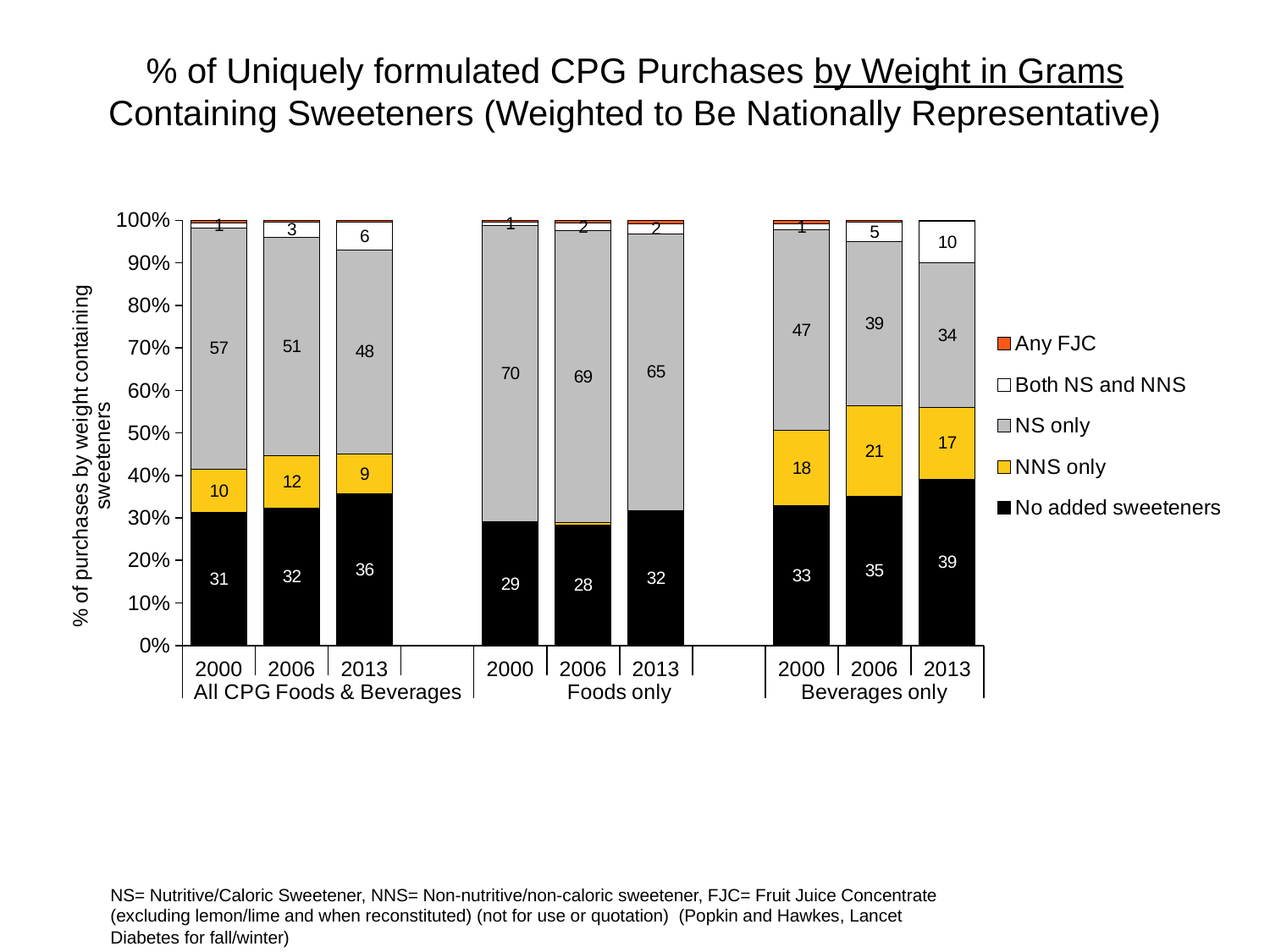
What is the value of the NS only segment for Foods only in 2000? 70 Across all nine bars, which bar has the highest NS only value? Foods only, 2000 What is the value of the NNS only segment for Beverages only in 2006? 21 How many bars are plotted in the chart? 9 What is the value of the Both NS and NNS segment for Beverages only in 2013? 10 Across all nine bars, which bar has the lowest No added sweeteners value? Foods only, 2006 What type of chart is shown on the slide? Stacked bar chart How does the No added sweeteners value for Beverages only change from 2000 to 2013? It rises What is the value of the No added sweeteners segment for All CPG Foods & Beverages in 2013? 36 Which is larger: the NNS only value for Beverages only in 2000 or for All CPG Foods & Beverages in 2006? Beverages only in 2000 What is the difference between the NS only values for All CPG Foods & Beverages in 2000 and 2013? 9 How many series does the legend list? 5